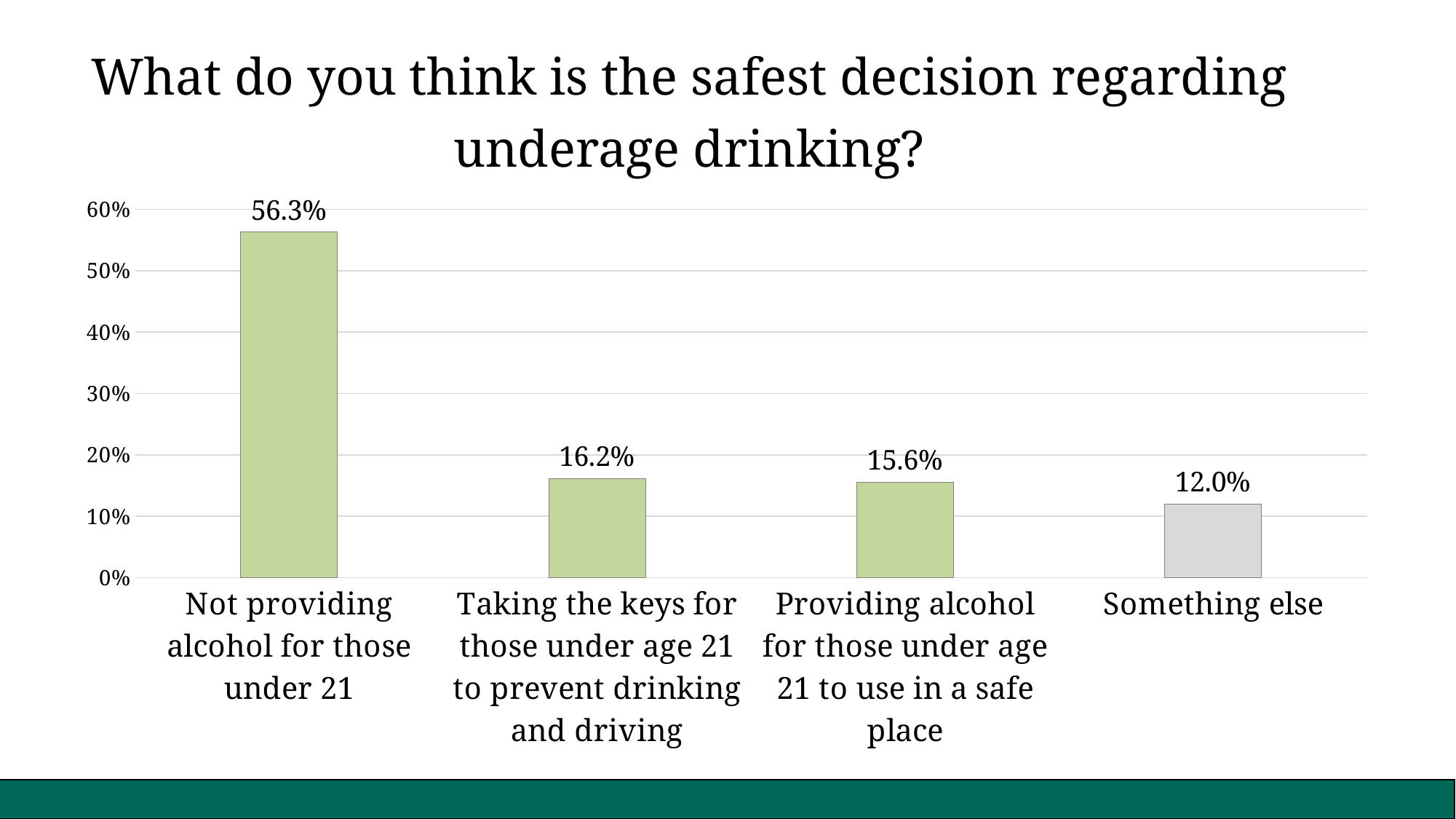
What is the difference between the values for "Not providing alcohol for those under 21" and "Something else"? 44.3% What is the difference between "Taking the keys for those under age 21 to prevent drinking and driving" and "Providing alcohol for those under age 21 to use in a safe place"? 0.6% What percentage is shown for "Providing alcohol for those under age 21 to use in a safe place"? 15.6% Which is larger: the value for "Taking the keys for those under age 21 to prevent drinking and driving" or the value for "Something else"? Taking the keys for those under age 21 to prevent drinking and driving What percentage of respondents chose "Not providing alcohol for those under 21" as the safest decision? 56.3% What type of chart is shown on the slide? Bar chart How many categories are shown in the chart? 4 What is the value for "Something else"? 12.0% Which category has the lowest value? Something else Which category has the highest value? Not providing alcohol for those under 21 Is the value for "Not providing alcohol for those under 21" greater or less than 50%? greater What is the value shown for "Taking the keys for those under age 21 to prevent drinking and driving"? 16.2%